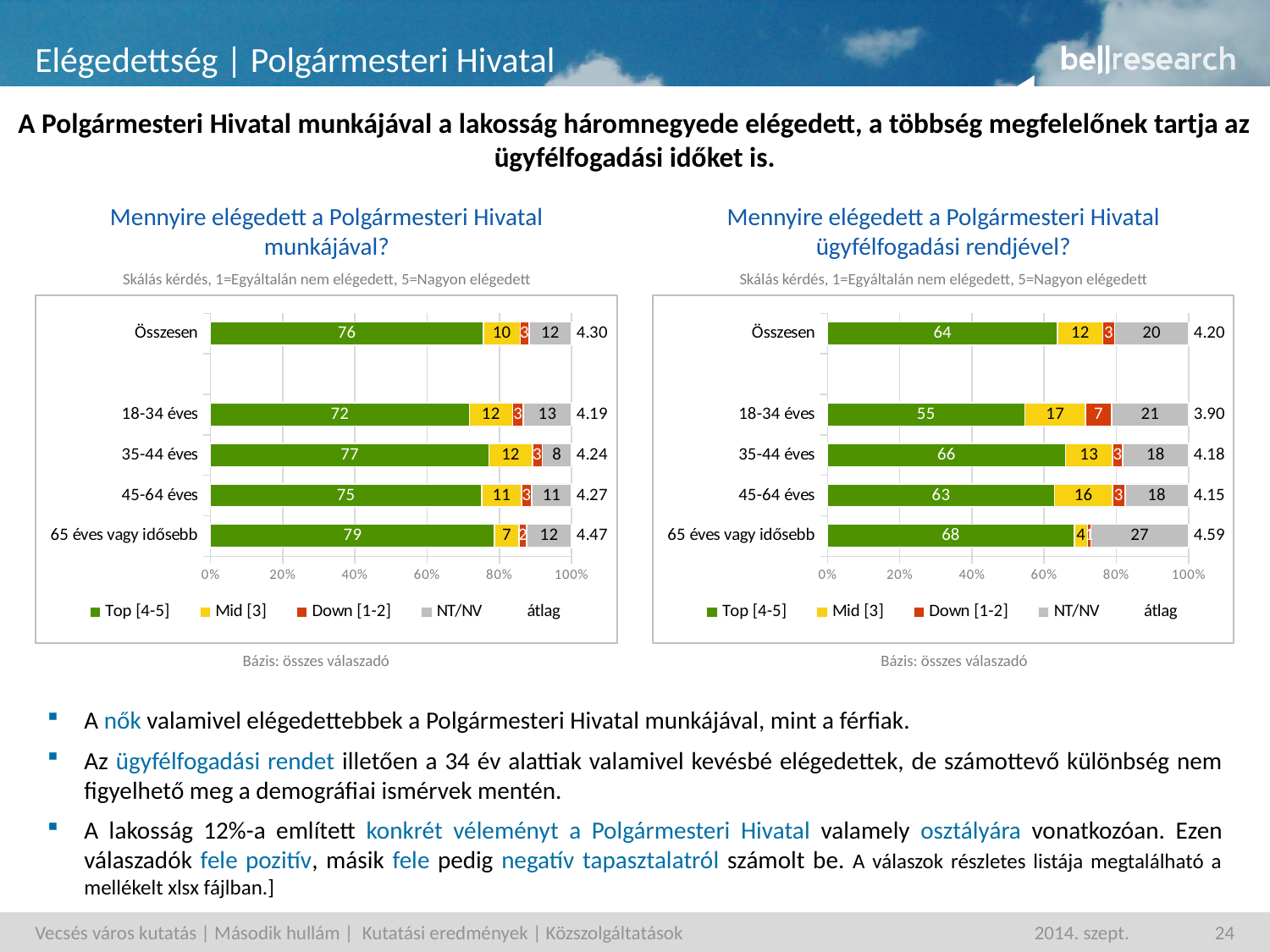
In the left chart (Mennyire elégedett a Polgármesteri Hivatal munkájával?), which age group has the highest Top [4-5] value? 65 éves vagy idősebb How many categories are shown on the y axis of the left chart (Mennyire elégedett a Polgármesteri Hivatal munkájával?)? 5 In the left chart (Mennyire elégedett a Polgármesteri Hivatal munkájával?), what is the difference between the Top [4-5] values for 65 éves vagy idősebb and 18-34 éves? 7 In the right chart (Mennyire elégedett a Polgármesteri Hivatal ügyfélfogadási rendjével?), what is the NT/NV value for 65 éves vagy idősebb? 27 In the left chart (Mennyire elégedett a Polgármesteri Hivatal munkájával?), which category has the lowest NT/NV value? 35-44 éves In the right chart (Mennyire elégedett a Polgármesteri Hivatal ügyfélfogadási rendjével?), which is larger: the Mid [3] value for 18-34 éves or for 35-44 éves? 18-34 éves In the right chart (Mennyire elégedett a Polgármesteri Hivatal ügyfélfogadási rendjével?), what is the Top [4-5] value for 18-34 éves? 55 In the right chart (Mennyire elégedett a Polgármesteri Hivatal ügyfélfogadási rendjével?), which category has the lowest átlag value? 18-34 éves What type of chart is the right chart (Mennyire elégedett a Polgármesteri Hivatal ügyfélfogadási rendjével?)? Stacked bar chart In the left chart (Mennyire elégedett a Polgármesteri Hivatal munkájával?), what is the Top [4-5] value for Összesen? 76 In the right chart (Mennyire elégedett a Polgármesteri Hivatal ügyfélfogadási rendjével?), what is the difference between the Down [1-2] values for 18-34 éves and Összesen? 4 In the left chart (Mennyire elégedett a Polgármesteri Hivatal munkájával?), what is the átlag value for 65 éves vagy idősebb? 4.47